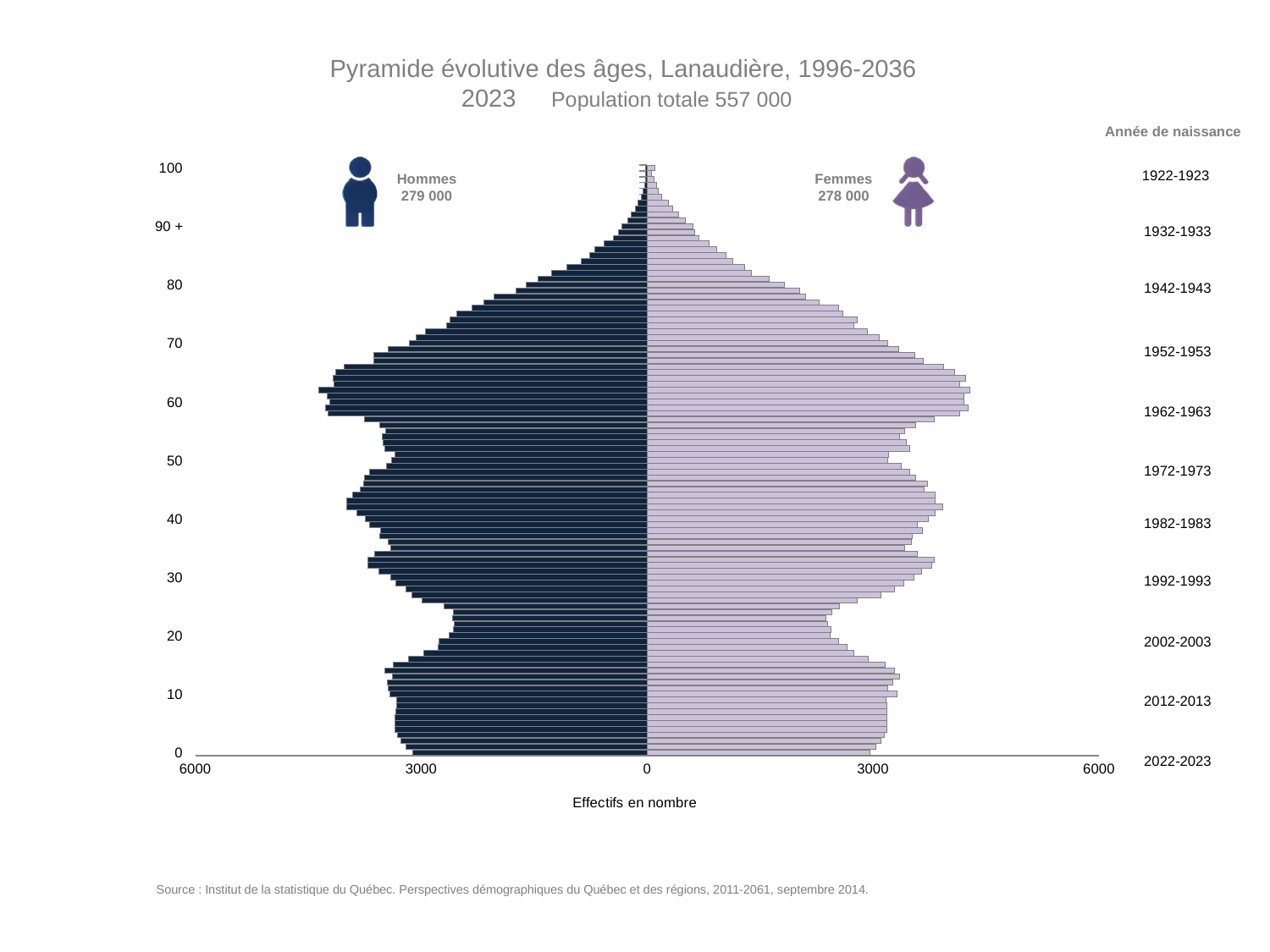
How many groups (series) does the chart show? 2 What is the title of the chart? Pyramide évolutive des âges, Lanaudière, 1996-2036 Is the value for Hommes at age 80 greater or less than 3000? less Is the value for Femmes at age 20 greater or less than 3000? less Which group is larger, Hommes or Femmes? Hommes Do the bars for Hommes rise or fall as age increases from 60 to 100? fall What total population is shown for 2023? 557 000 What is the difference between the number of Hommes and the number of Femmes? 1 000 What is the number of Hommes shown on the chart? 279 000 What kind of chart is this? bar chart (population pyramid) What is the number of Femmes shown on the chart? 278 000 Is the value for Hommes at age 60 greater or less than 3000? greater